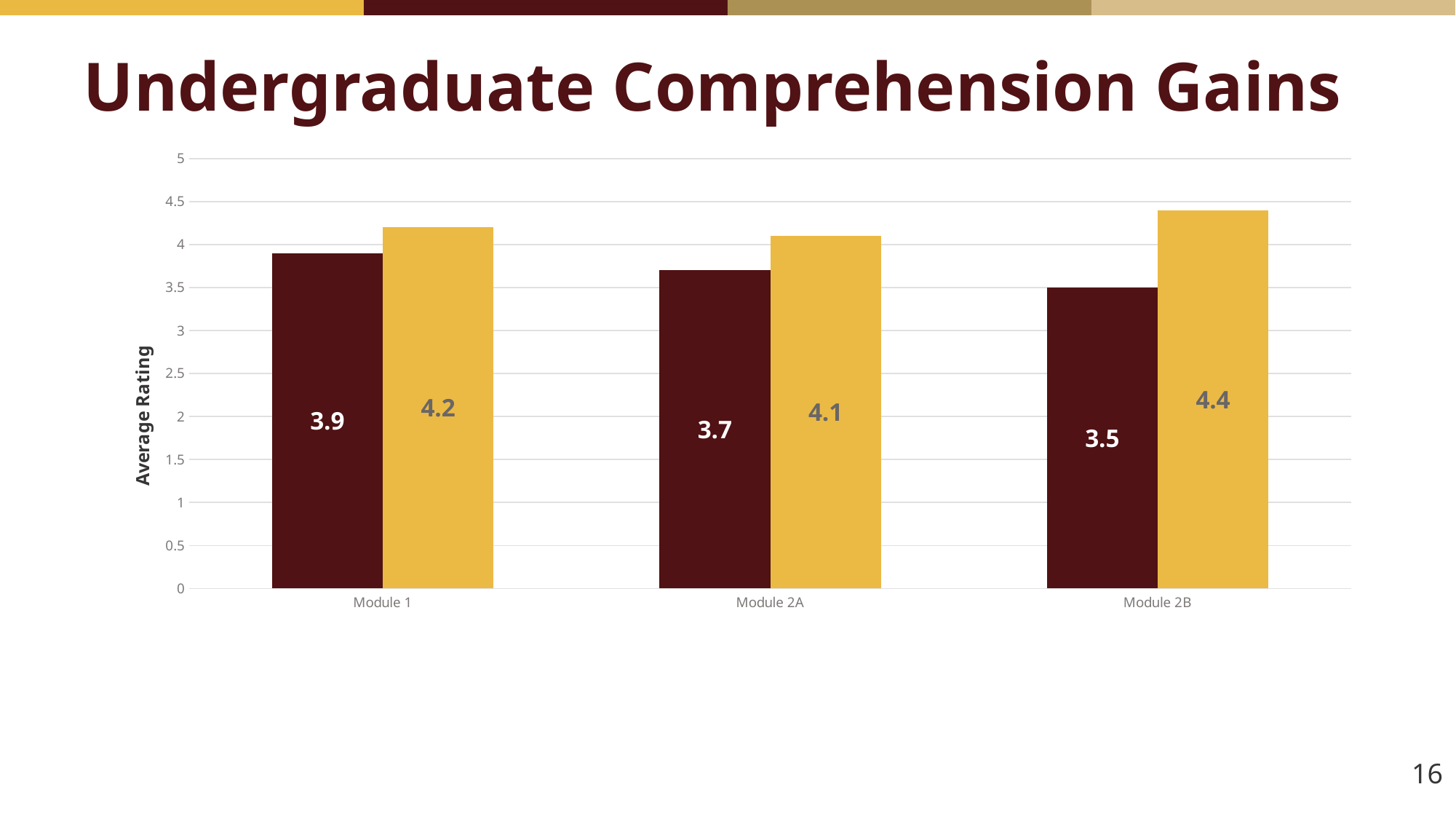
Which module has the lowest dark red bar? Module 2B Which module has the highest gold bar? Module 2B What is the value of the gold bar for Module 2A? 4.1 How many modules are shown on the x axis? 3 What is the difference between the dark red bars for Module 1 and Module 2A? 0.2 What is the label of the vertical axis? Average Rating What is the value of the dark red bar for Module 1? 3.9 Is the value of the dark red bar for Module 2B greater or less than 4? less What is the value of the gold bar for Module 2B? 4.4 What kind of chart is shown on the slide? bar chart What is the difference between the gold bar and the dark red bar for Module 2B? 0.9 Which is larger for Module 1, the dark red bar or the gold bar? the gold bar